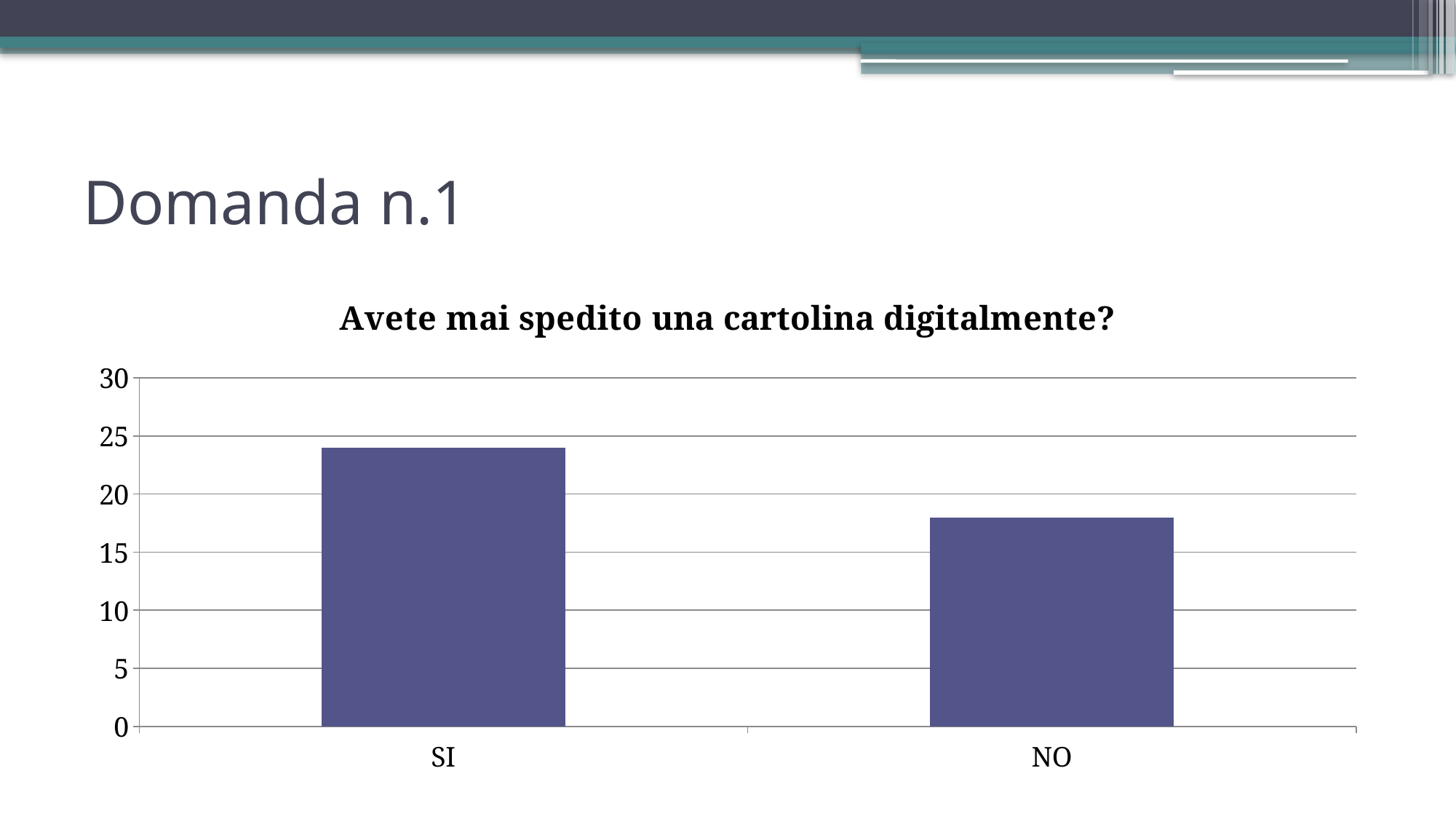
Is the value for NO greater or less than 15? greater What kind of chart is shown on the slide? bar chart How many categories are shown on the x axis of the chart? 2 Which category has the highest value? SI What is the highest value shown on the y axis of the chart? 30 Is the value for SI greater or less than 25? less Which category has the lowest value? NO Is the value for SI greater or less than 20? greater What is the title of the chart? Avete mai spedito una cartolina digitalmente? Which is larger, the value for SI or the value for NO? SI